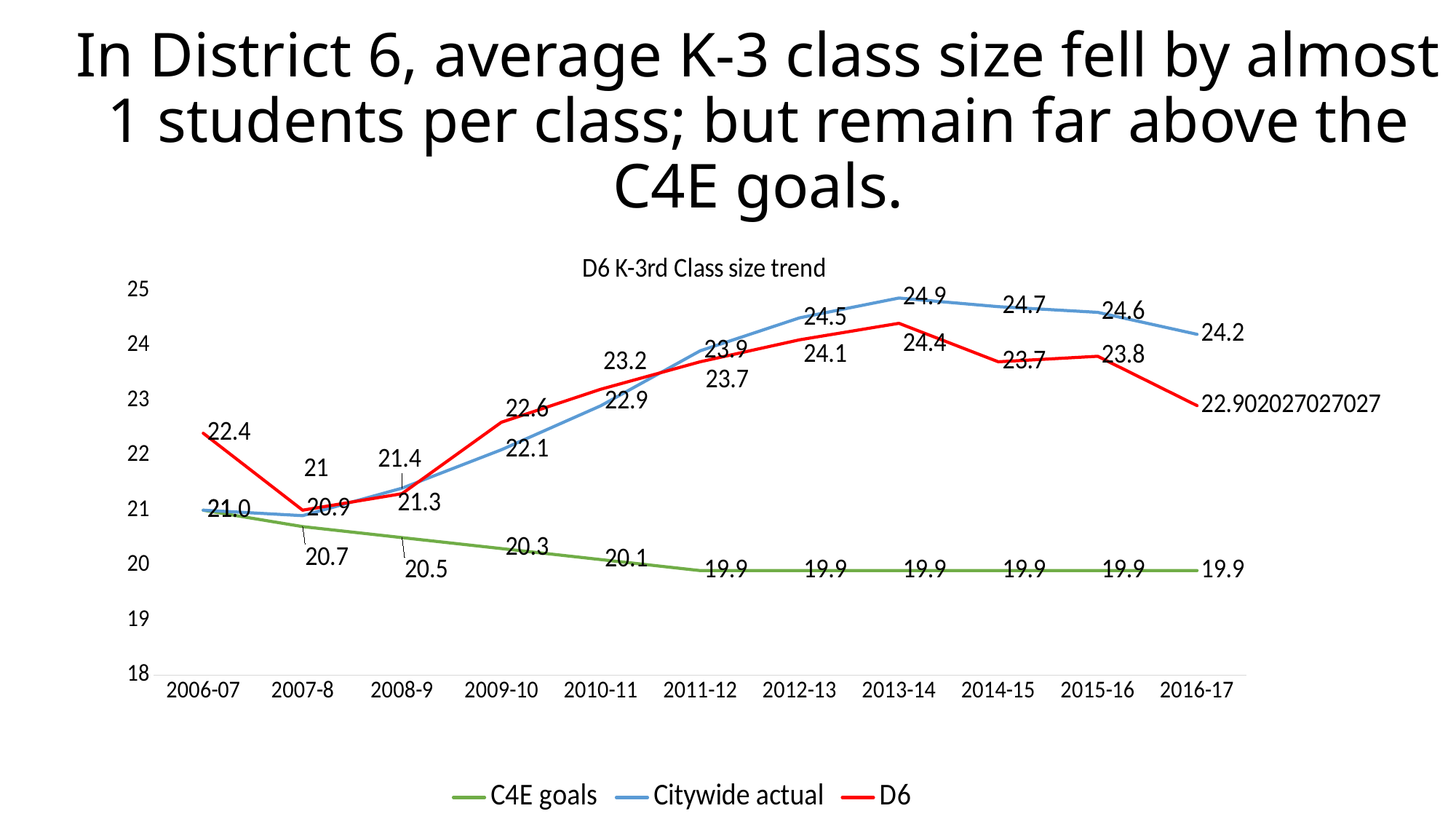
In which year does the Citywide actual series reach its highest value? 2013-14 How many series does the legend list? 3 What kind of chart is shown on the slide? line chart What is the Citywide actual value for 2016-17? 24.2 How many school years are plotted along the x axis? 11 What is the C4E goals value for 2016-17? 19.9 Do the C4E goals values rise or fall from 2006-07 to 2016-17? fall What is the difference between the Citywide actual value and the D6 value in 2013-14? 0.5 In which year is the D6 value lowest? 2007-8 In 2014-15, which is larger: the Citywide actual value or the D6 value? Citywide actual What is the D6 value for 2006-07? 22.4 What is the D6 value for 2013-14? 24.4